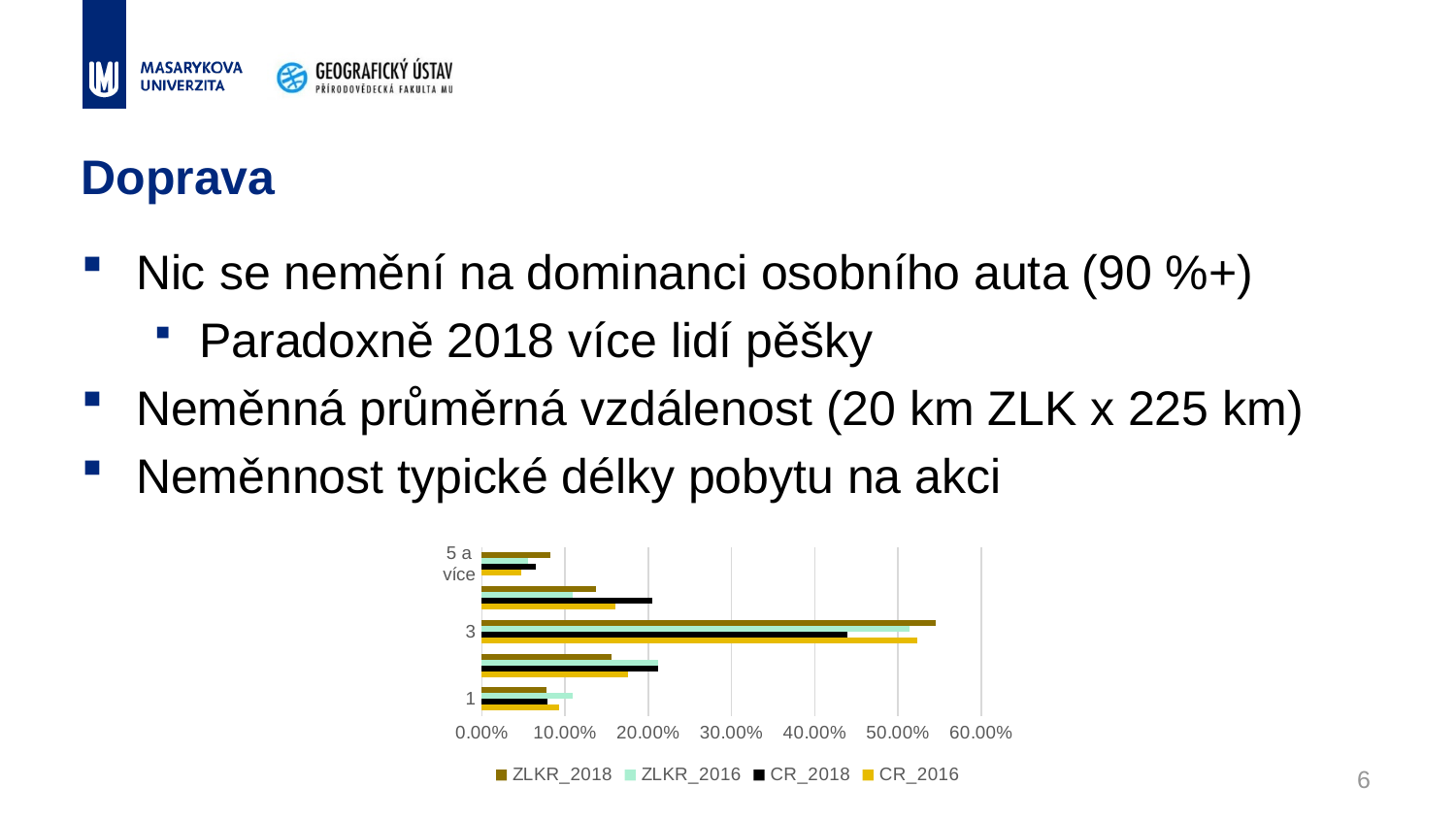
In category 3, which is larger: the value for ZLKR_2018 or the value for CR_2018? ZLKR_2018 How many series does the chart legend list? 4 What kind of chart is shown on the slide? bar chart How many categories are plotted on the vertical axis of the chart? 5 What is the highest tick label shown on the horizontal axis of the chart? 60.00% Is the value for ZLKR_2018 in category 3 greater or less than 50.00%? greater Which category has the highest value for the ZLKR_2018 series? 3 Is the value for CR_2018 in category 3 greater or less than 50.00%? less Is the value for ZLKR_2018 in category 1 greater or less than 10.00%? less Which series are listed in the chart legend? ZLKR_2018, ZLKR_2016, CR_2018, CR_2016 Which category has the highest value for the CR_2016 series? 3